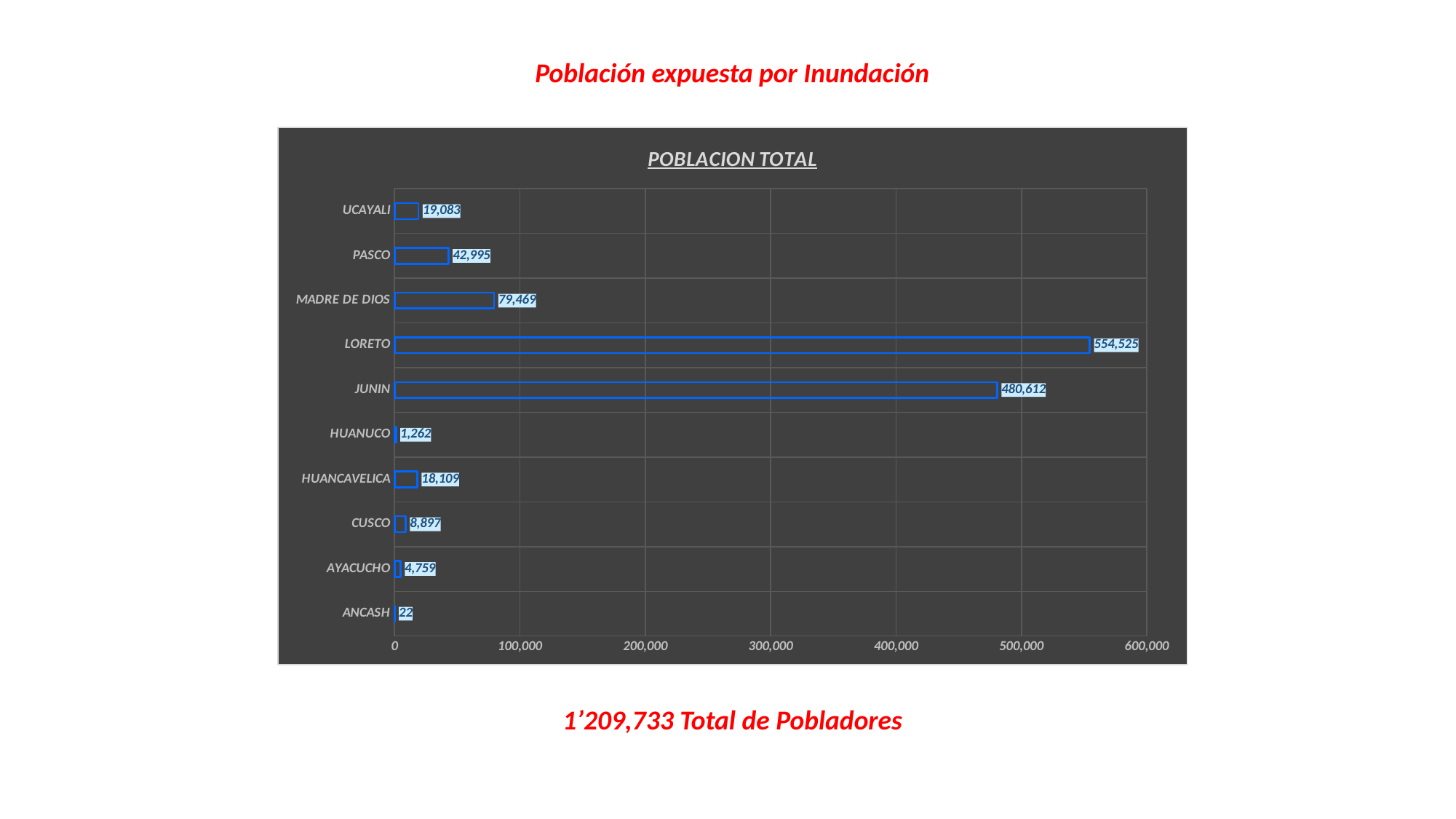
What is the difference between the values for LORETO and JUNIN? 73,913 What is the value for HUANCAVELICA? 18,109 Is the value for JUNIN greater or less than 400,000? greater Which is larger, the value for PASCO or the value for UCAYALI? PASCO How many categories are shown in the chart? 10 What is the title of the chart? POBLACION TOTAL What is the difference between the values for PASCO and UCAYALI? 23,912 Which category has the highest value? LORETO What is the value for MADRE DE DIOS? 79,469 Which category has the lowest value? ANCASH What kind of chart is shown? bar chart What is the value for LORETO? 554,525